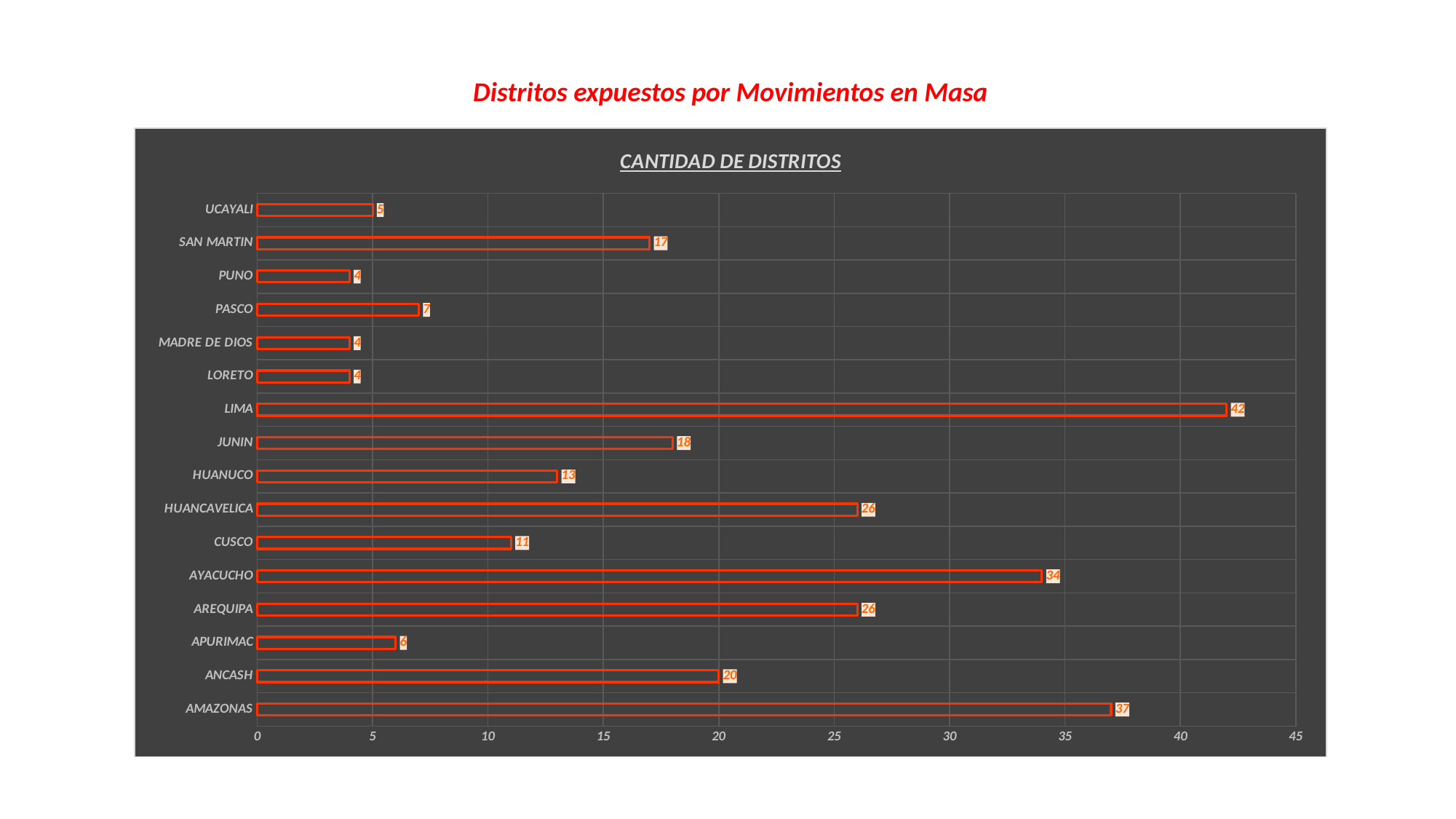
What is the value for LIMA? 42 Which is larger, the value for JUNIN or the value for HUANUCO? JUNIN What is the value for SAN MARTIN? 17 What is the value for APURIMAC? 6 What is the value for HUANCAVELICA? 26 What is the title of the chart? CANTIDAD DE DISTRITOS Which category has the highest value? LIMA What is the difference between the values for AMAZONAS and AYACUCHO? 3 What kind of chart is shown? bar chart How many categories are shown on the chart? 16 Is the value for ANCASH greater or less than 15? greater What is the difference between the values for LIMA and UCAYALI? 37